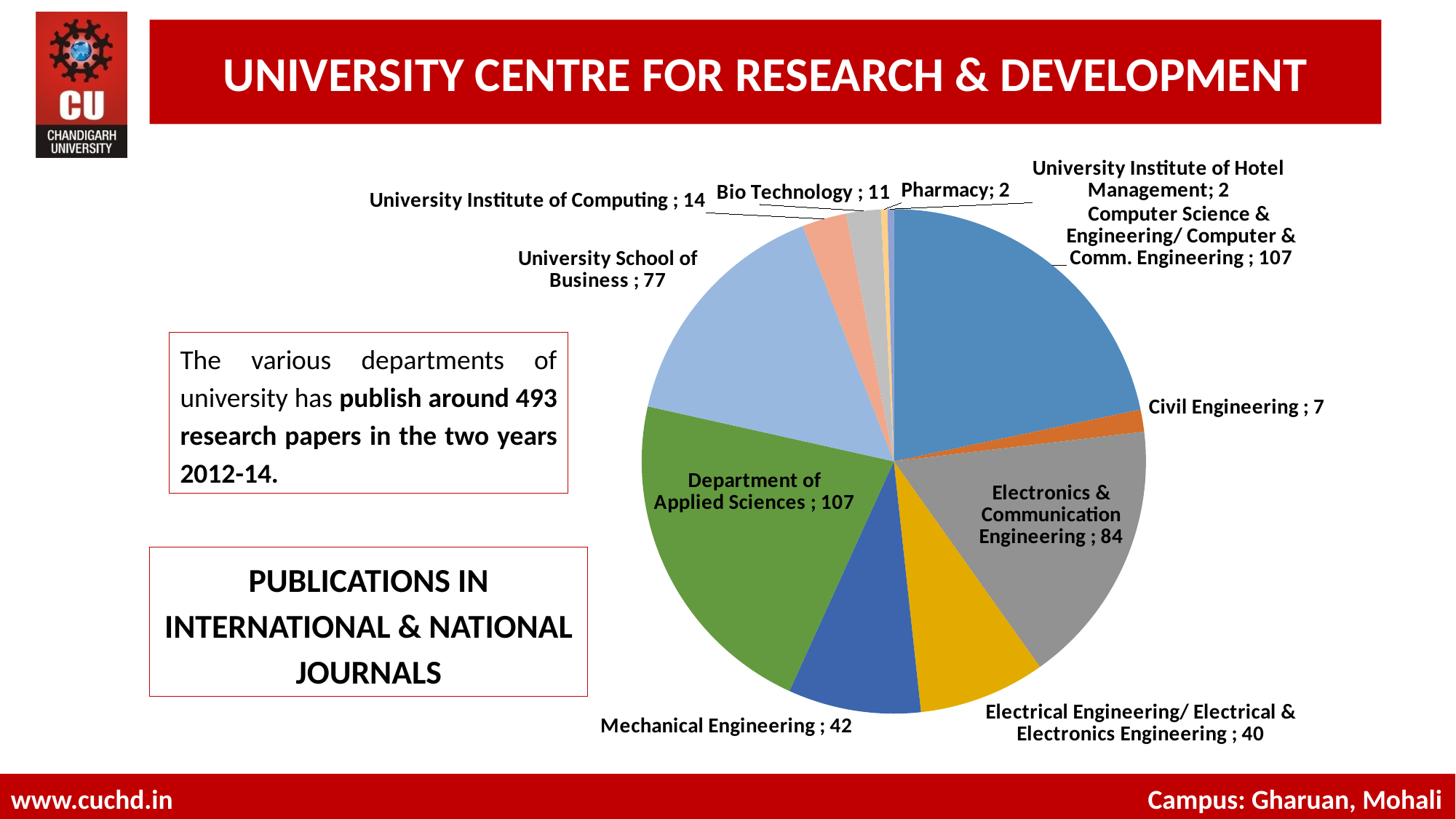
What is the value for Electronics & Communication Engineering in the pie chart? 84 What is the value for Department of Applied Sciences in the pie chart? 107 Which is larger in the pie chart, Mechanical Engineering or Electrical Engineering/ Electrical & Electronics Engineering? Mechanical Engineering What is the value for University School of Business in the pie chart? 77 What is the difference between the values for University School of Business and Mechanical Engineering? 35 What is the value for Civil Engineering in the pie chart? 7 What is the value for Bio Technology in the pie chart? 11 How many slices does the pie chart have? 11 What is the total of all the slices in the pie chart? 493 What colour is the Department of Applied Sciences slice in the pie chart? green What kind of chart is shown on the slide? pie chart What is the difference between the values for Computer Science & Engineering/ Computer & Comm. Engineering and Electronics & Communication Engineering? 23